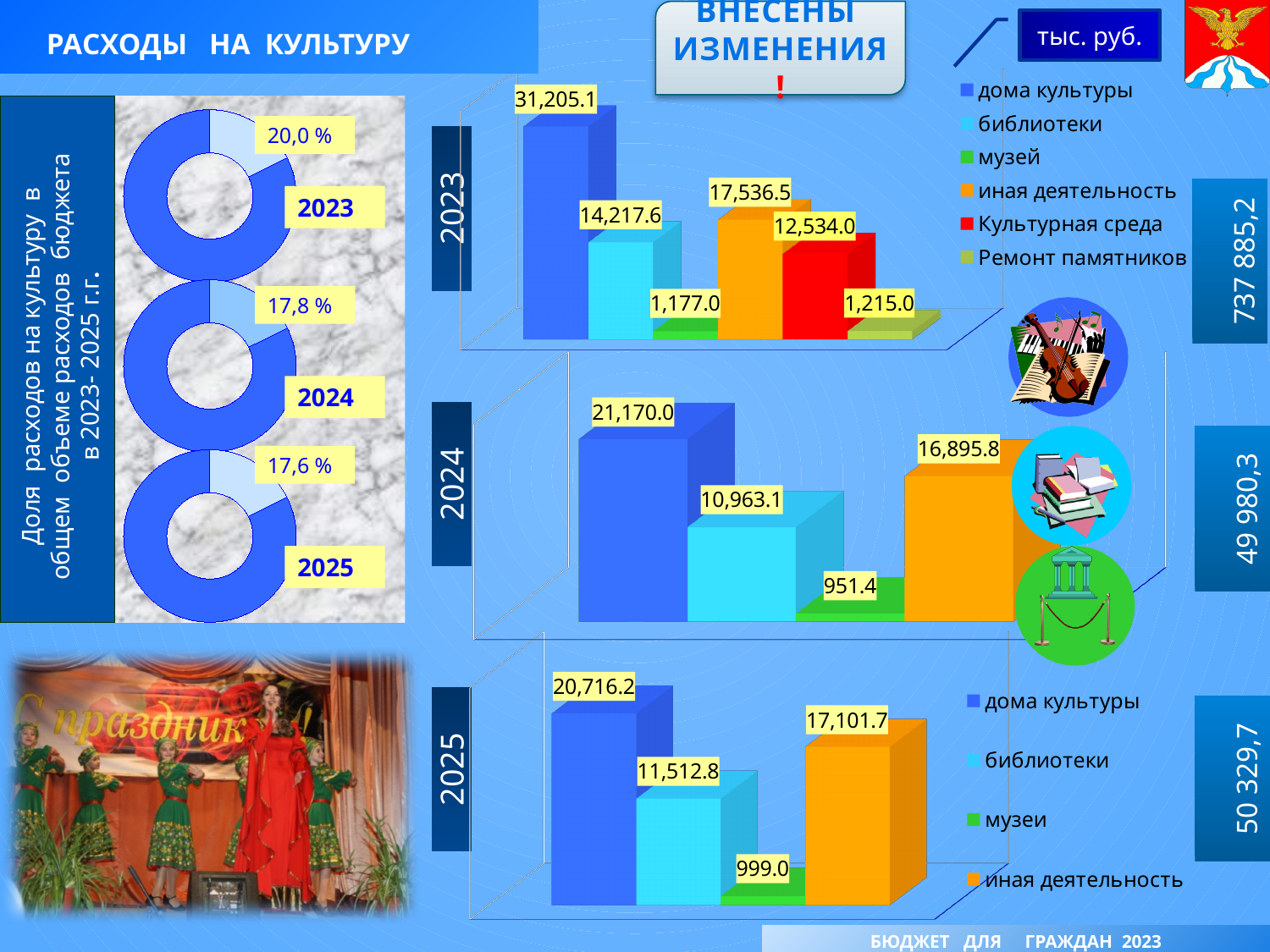
In the 2025 bar chart, which is larger: библиотеки or иная деятельность? иная деятельность How many series does the legend of the 2023 bar chart list? 6 In the donut charts on the left, what share is shown for 2024? 17,8 % Across the donut charts on the left, do the shares rise or fall from 2023 to 2025? fall In the 2025 bar chart, what is the value for музеи? 999.0 In the 2023 bar chart, what is the value for дома культуры? 31,205.1 How many bars are plotted in the 2025 bar chart? 4 In the 2024 bar chart, what is the difference between дома культуры and библиотеки? 10,206.9 In the 2023 bar chart, which category has the lowest value? музей In the 2024 bar chart, which category has the highest value? дома культуры In the 2023 bar chart, what is the value for Культурная среда? 12,534.0 In the 2024 bar chart, what is the value for иная деятельность? 16,895.8